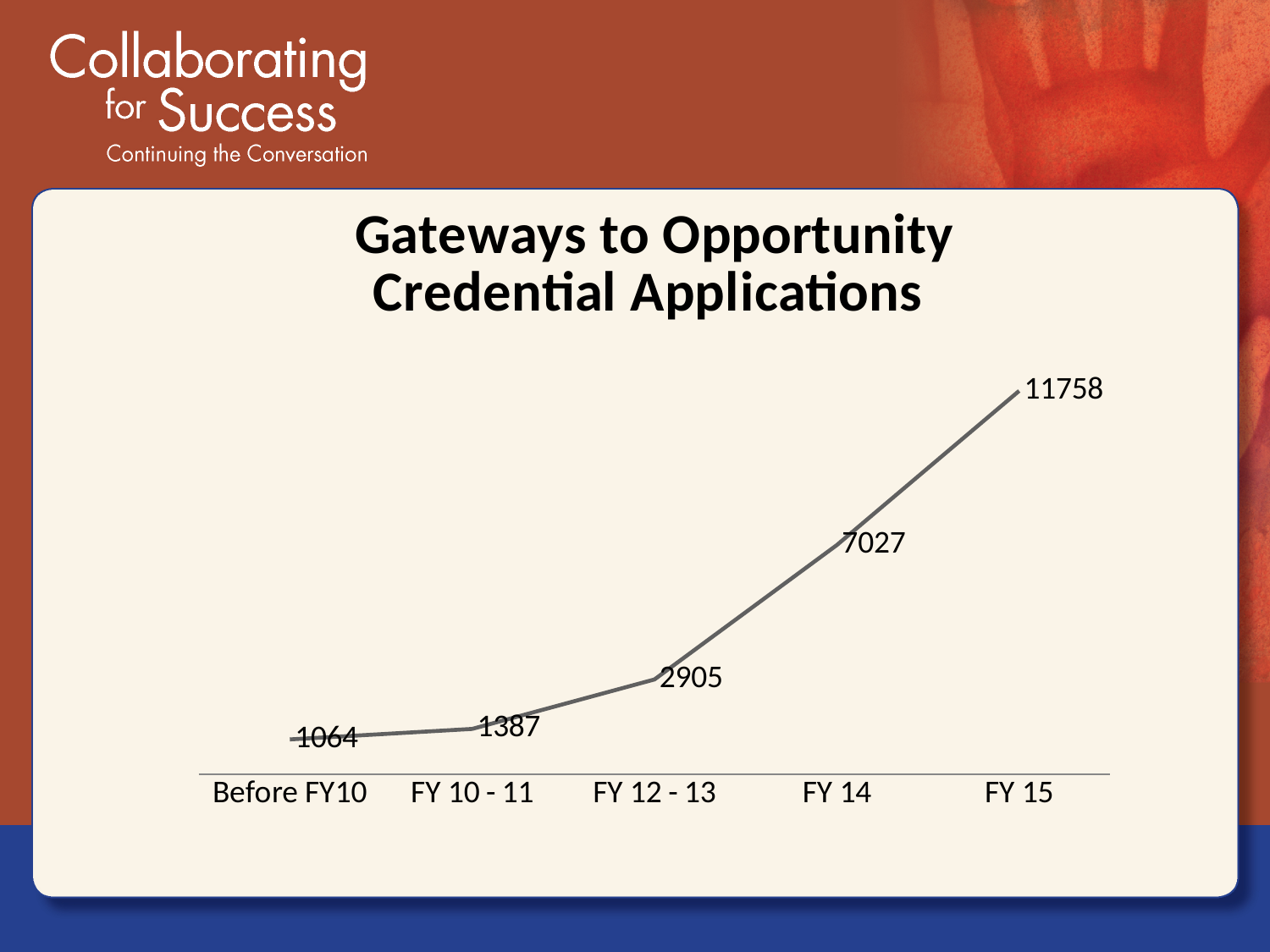
What is the value for FY 15? 11758 Do the values rise or fall from Before FY10 to FY 15? rise How many categories are shown on the x axis? 5 What is the value for FY 14? 7027 Which category has the lowest value? Before FY10 What is the value for FY 12 - 13? 2905 What is the value for Before FY10? 1064 What is the difference between the values for FY 15 and FY 14? 4731 What kind of chart is this? line chart Which is larger, the value for FY 14 or the value for FY 12 - 13? FY 14 What is the difference between the values for FY 10 - 11 and Before FY10? 323 Which category has the highest value? FY 15